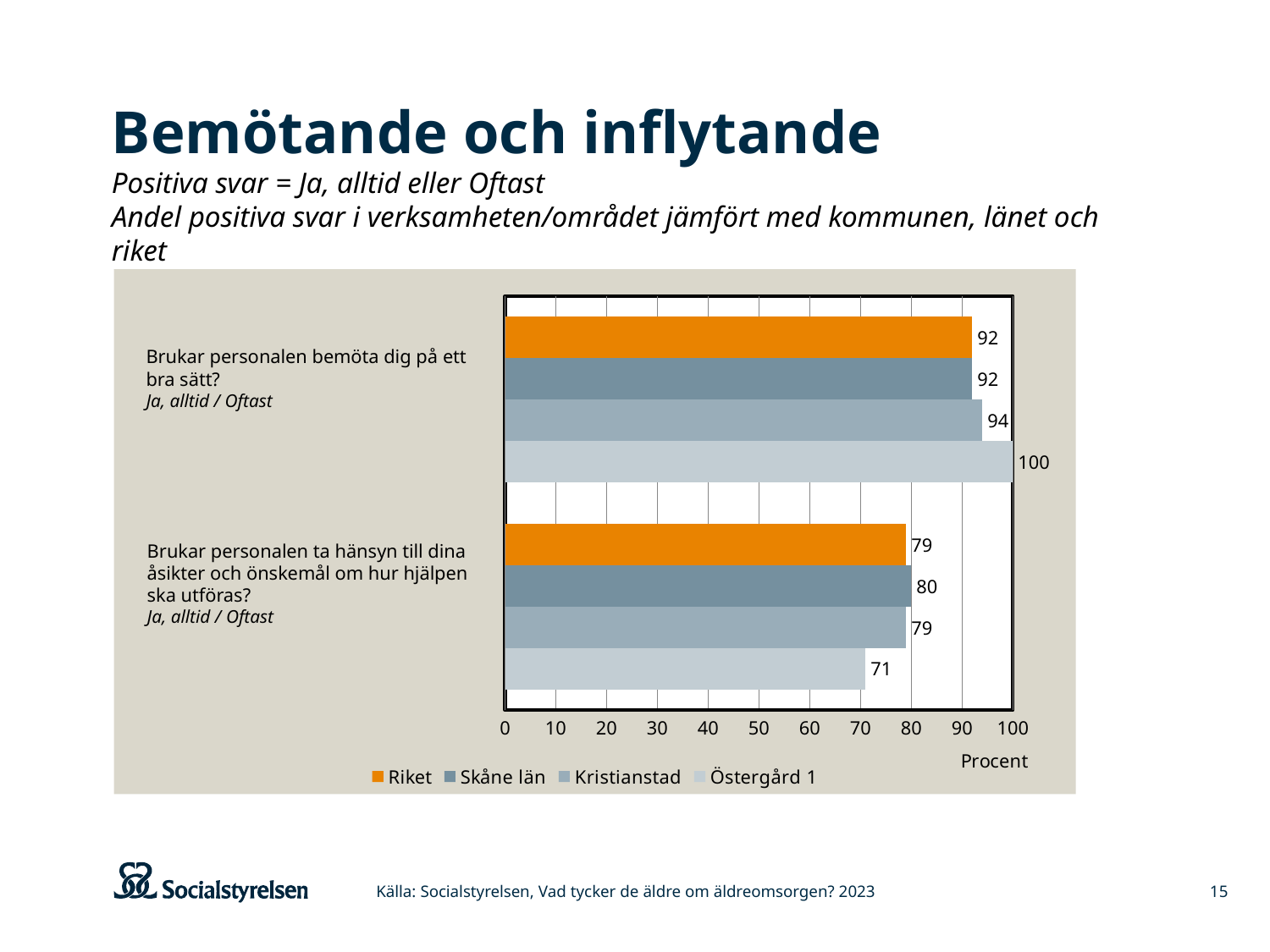
What kind of chart is shown on the slide? bar chart What is the value for Östergård 1 for the question "Brukar personalen ta hänsyn till dina åsikter och önskemål om hur hjälpen ska utföras?"? 71 How many series does the legend list? 4 What is the value for Riket for the question "Brukar personalen ta hänsyn till dina åsikter och önskemål om hur hjälpen ska utföras?"? 79 What is the value for Kristianstad for the question "Brukar personalen bemöta dig på ett bra sätt?"? 94 Which is larger for the question "Brukar personalen ta hänsyn till dina åsikter och önskemål om hur hjälpen ska utföras?": Skåne län or Östergård 1? Skåne län Which series has the highest value for the question "Brukar personalen bemöta dig på ett bra sätt?"? Östergård 1 How many questions (categories) are shown on the chart? 2 What is the value for Östergård 1 for the question "Brukar personalen bemöta dig på ett bra sätt?"? 100 What is the difference between the Östergård 1 values for the two questions? 29 Which series has the lowest value for the question "Brukar personalen ta hänsyn till dina åsikter och önskemål om hur hjälpen ska utföras?"? Östergård 1 What is the label on the horizontal axis of the chart? Procent